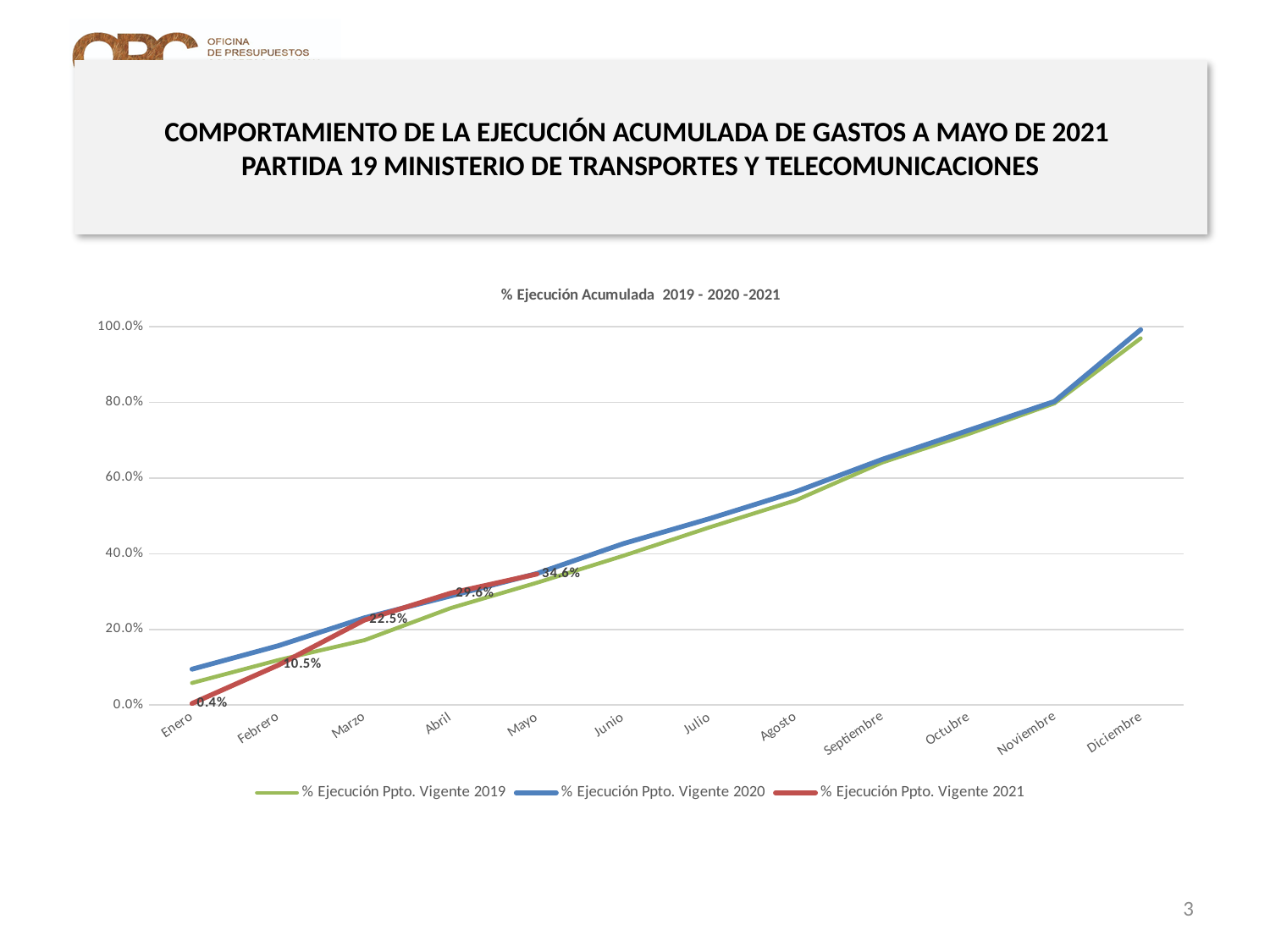
What is the value for Marzo in the % Ejecución Ppto. Vigente 2021 series? 22.5% What kind of chart is shown on the slide? Line chart What is the value for Mayo in the % Ejecución Ppto. Vigente 2021 series? 34.6% Which of the labelled months has the highest value in the % Ejecución Ppto. Vigente 2021 series? Mayo What is the value for Enero in the % Ejecución Ppto. Vigente 2021 series? 0.4% How many months are shown on the x axis? 12 Do the values of the % Ejecución Ppto. Vigente 2020 series rise or fall from Enero to Diciembre? Rise What is the difference between the Mayo and Abril values of the % Ejecución Ppto. Vigente 2021 series? 5.0% What is the title of the chart? % Ejecución Acumulada 2019 - 2020 -2021 Is the Diciembre value for % Ejecución Ppto. Vigente 2020 greater or less than 80.0%? greater Which of the labelled months has the lowest value in the % Ejecución Ppto. Vigente 2021 series? Enero How many series does the legend list? 3